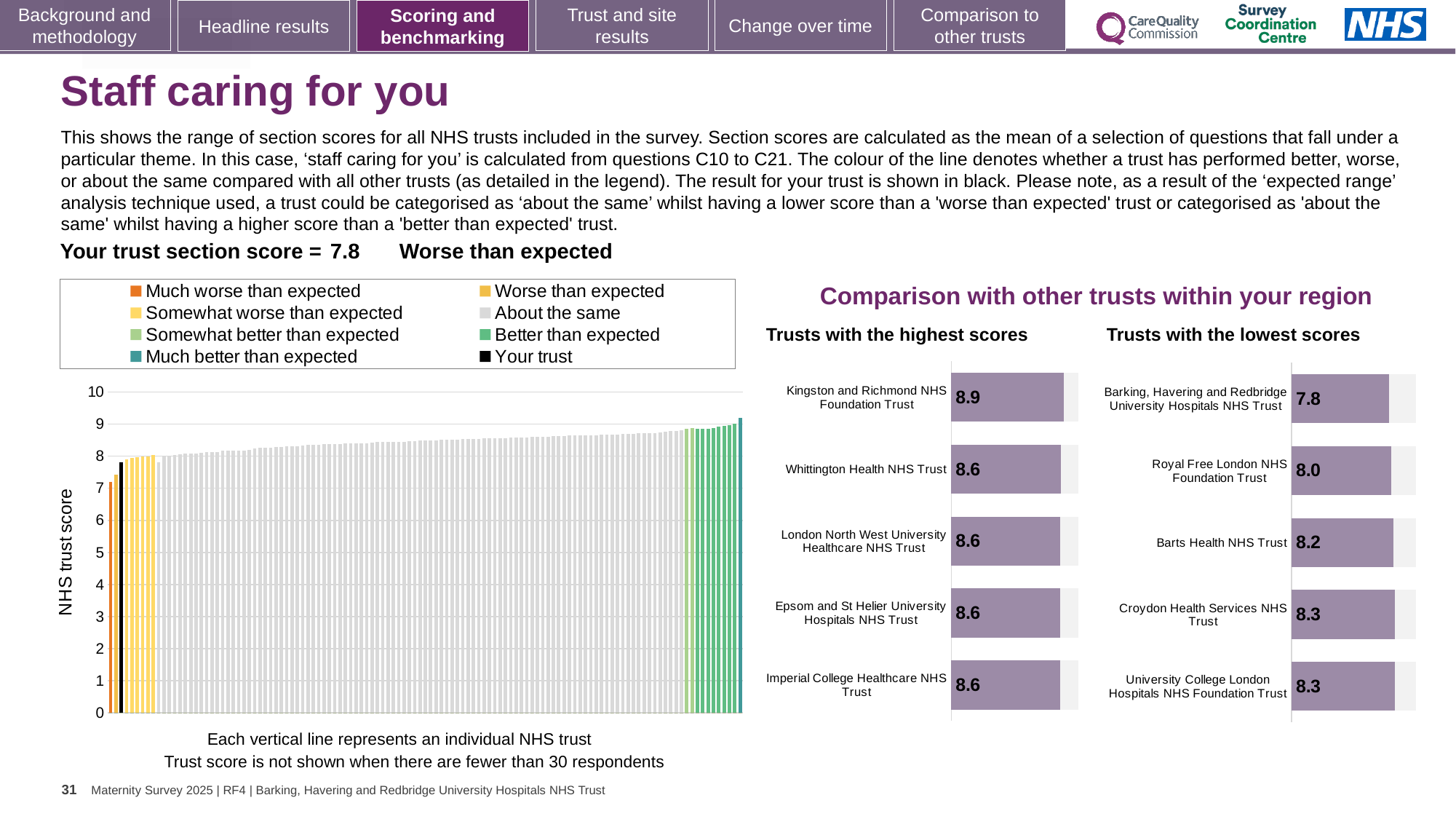
In the NHS trust score chart on the left, what colour is used for 'Your trust'? Black What is your trust's section score for 'Staff caring for you'? 7.8 In the NHS trust score chart on the left, do the bars rise or fall from left to right? Rise In the 'Trusts with the lowest scores' chart, what is the difference between the scores of Croydon Health Services NHS Trust and Royal Free London NHS Foundation Trust? 0.3 How many trusts are shown in the 'Trusts with the highest scores' chart? 5 In the 'Trusts with the highest scores' chart, which trust has the highest score? Kingston and Richmond NHS Foundation Trust In the 'Trusts with the highest scores' chart, what is the score for Kingston and Richmond NHS Foundation Trust? 8.9 In the 'Trusts with the lowest scores' chart, which has the higher score: Barts Health NHS Trust or Royal Free London NHS Foundation Trust? Barts Health NHS Trust In the 'Trusts with the lowest scores' chart, what is the score for Barts Health NHS Trust? 8.2 How many entries does the legend of the NHS trust score chart list? 8 In the 'Trusts with the lowest scores' chart, which trust has the lowest score? Barking, Havering and Redbridge University Hospitals NHS Trust What kind of chart is the NHS trust score chart on the left? Bar chart